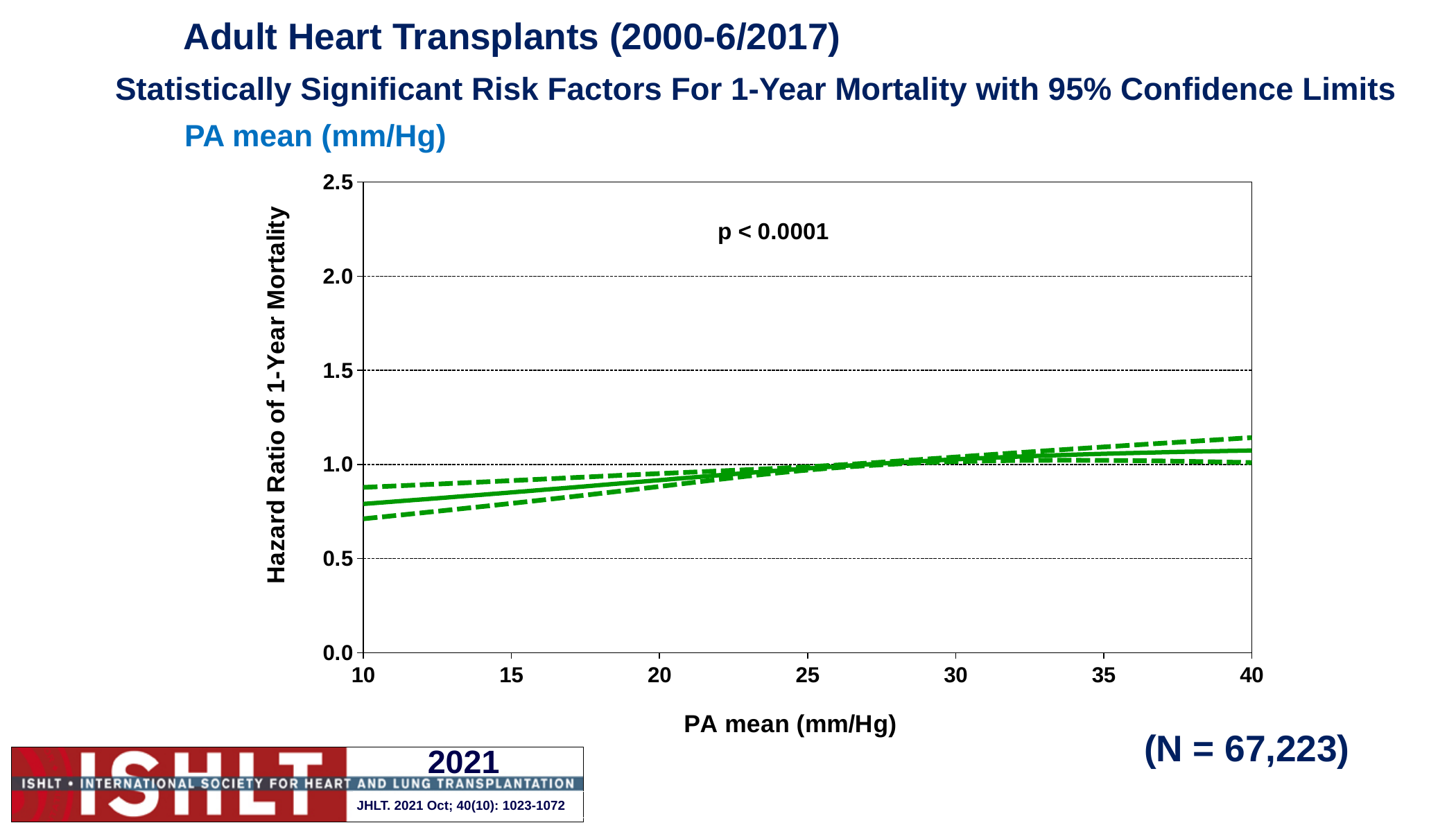
What is the highest value shown on the y axis? 2.5 Is the lower confidence limit (lower dashed line) at a PA mean of 10 mm/Hg greater or less than 0.5? greater What is the label of the y axis? Hazard Ratio of 1-Year Mortality Does the hazard ratio of 1-year mortality rise or fall as PA mean increases from 10 to 40 mm/Hg? rise Is the upper confidence limit (upper dashed line) at a PA mean of 10 mm/Hg greater or less than 1.0? less What kind of chart is shown on the slide? line chart Which has the larger hazard ratio on the solid line: a PA mean of 10 mm/Hg or a PA mean of 40 mm/Hg? 40 mm/Hg Is the upper confidence limit (upper dashed line) at a PA mean of 40 mm/Hg greater or less than 1.5? less How many lines are plotted on the chart? 3 What p-value is printed on the chart? p < 0.0001